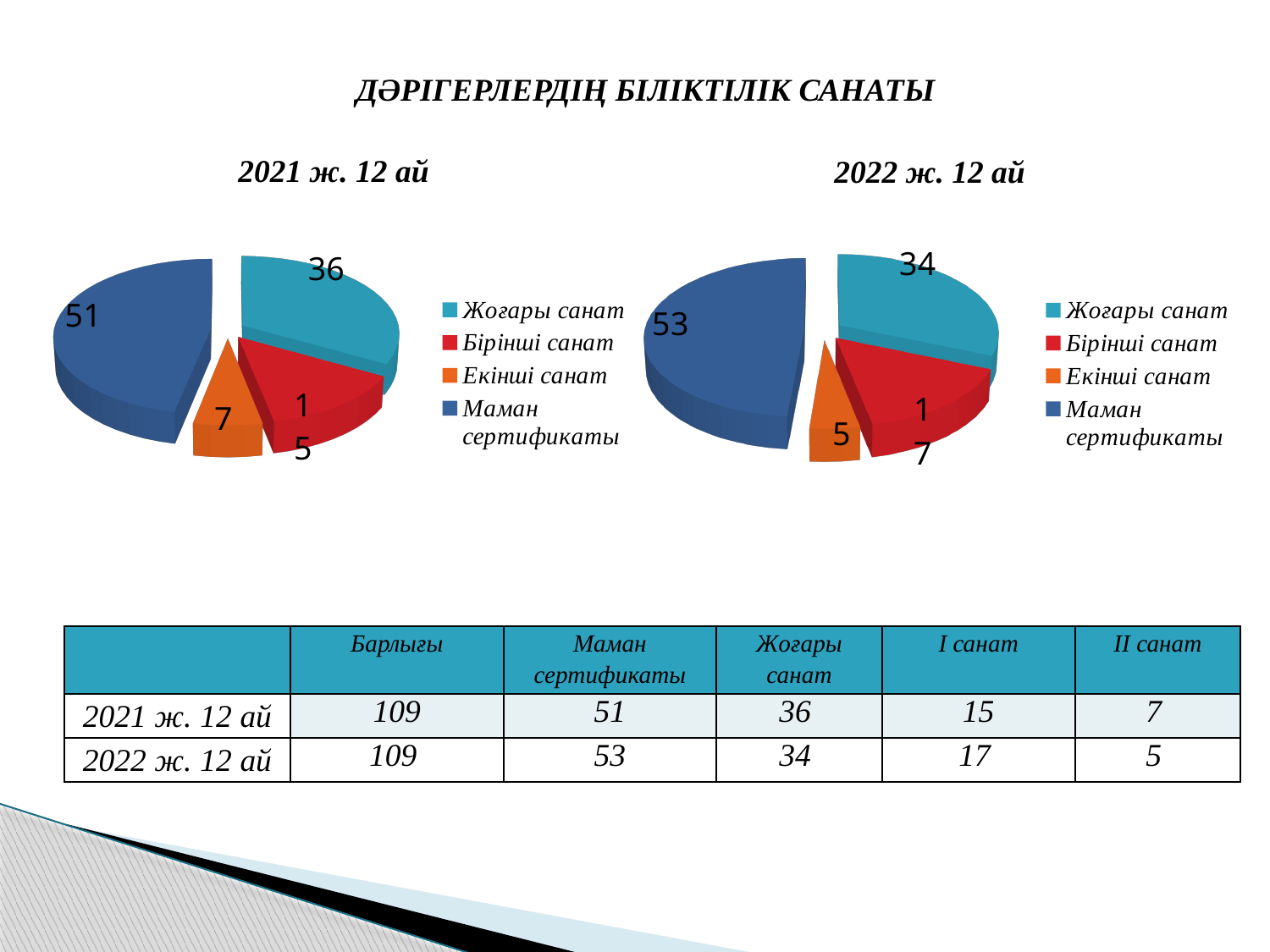
How many entries does the legend of the 2022 ж. 12 ай chart list? 4 What is the title of the slide above the two charts? ДӘРІГЕРЛЕРДІҢ БІЛІКТІЛІК САНАТЫ In the 2021 ж. 12 ай pie chart, what is the value for Маман сертификаты? 51 In the 2022 ж. 12 ай pie chart, what is the value for Екінші санат? 5 In the 2021 ж. 12 ай pie chart, what is the value for Жоғары санат? 36 In the 2021 ж. 12 ай pie chart, what is the difference between the Маман сертификаты value and the Жоғары санат value? 15 What kind of chart is used for 2021 ж. 12 ай? Pie chart In the 2022 ж. 12 ай pie chart, which category has the largest slice? Маман сертификаты In the 2021 ж. 12 ай pie chart, which category has the smallest slice? Екінші санат How many slices does the 2021 ж. 12 ай pie chart have? 4 In the 2022 ж. 12 ай pie chart, what is the value for Бірінші санат? 17 In the 2022 ж. 12 ай pie chart, which is larger: Жоғары санат or Бірінші санат? Жоғары санат